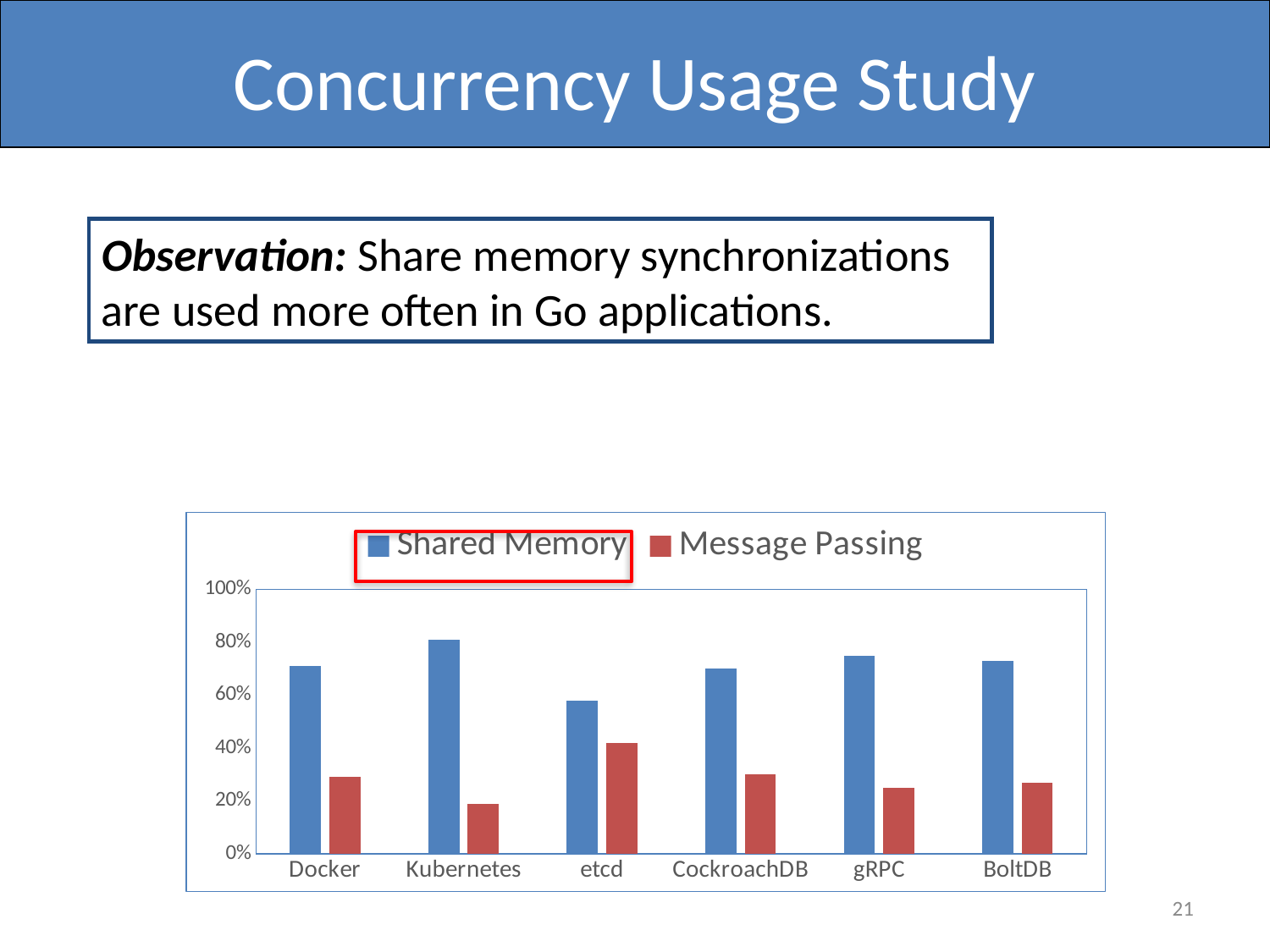
For Docker, which is larger: Shared Memory or Message Passing? Shared Memory Which application has the lowest Message Passing value? Kubernetes Which application has the lowest Shared Memory value? etcd What kind of chart is shown on the slide? bar chart Which application has the highest Message Passing value? etcd How many series does the legend list? 2 Which legend entry is highlighted with a red box? Shared Memory Is the Shared Memory value for gRPC greater or less than 60%? greater Which application has the highest Shared Memory value? Kubernetes Is the Message Passing value for Docker greater or less than 40%? less How many applications (categories) are shown on the x axis? 6 Is the Shared Memory value for Kubernetes greater or less than 60%? greater